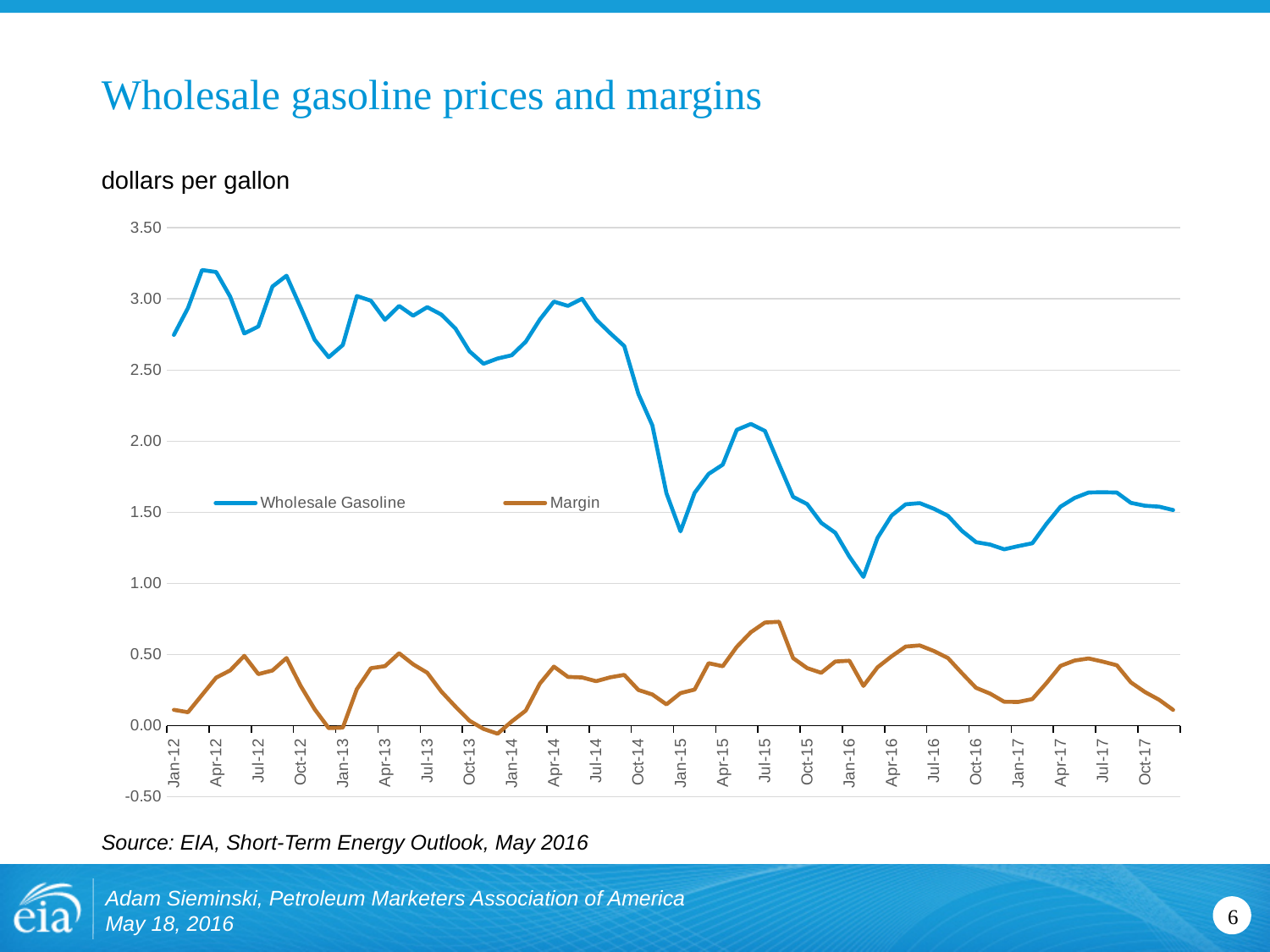
Is the Margin value at Jul-15 greater or less than 0.50? greater How many x-axis tick labels are shown on the chart? 24 Is the Margin value at Jan-17 greater or less than 0.50? less Which is larger, the Wholesale Gasoline value at Apr-12 or at Jan-16? Apr-12 Is the Wholesale Gasoline value at Jan-15 greater or less than 1.50? less Does the Wholesale Gasoline line rise or fall between Jul-14 and Jan-15? Fall How many series does the legend list? 2 What kind of chart is shown on the slide? Line chart What unit is shown above the y axis of the chart? dollars per gallon What is the title of the chart? Wholesale gasoline prices and margins